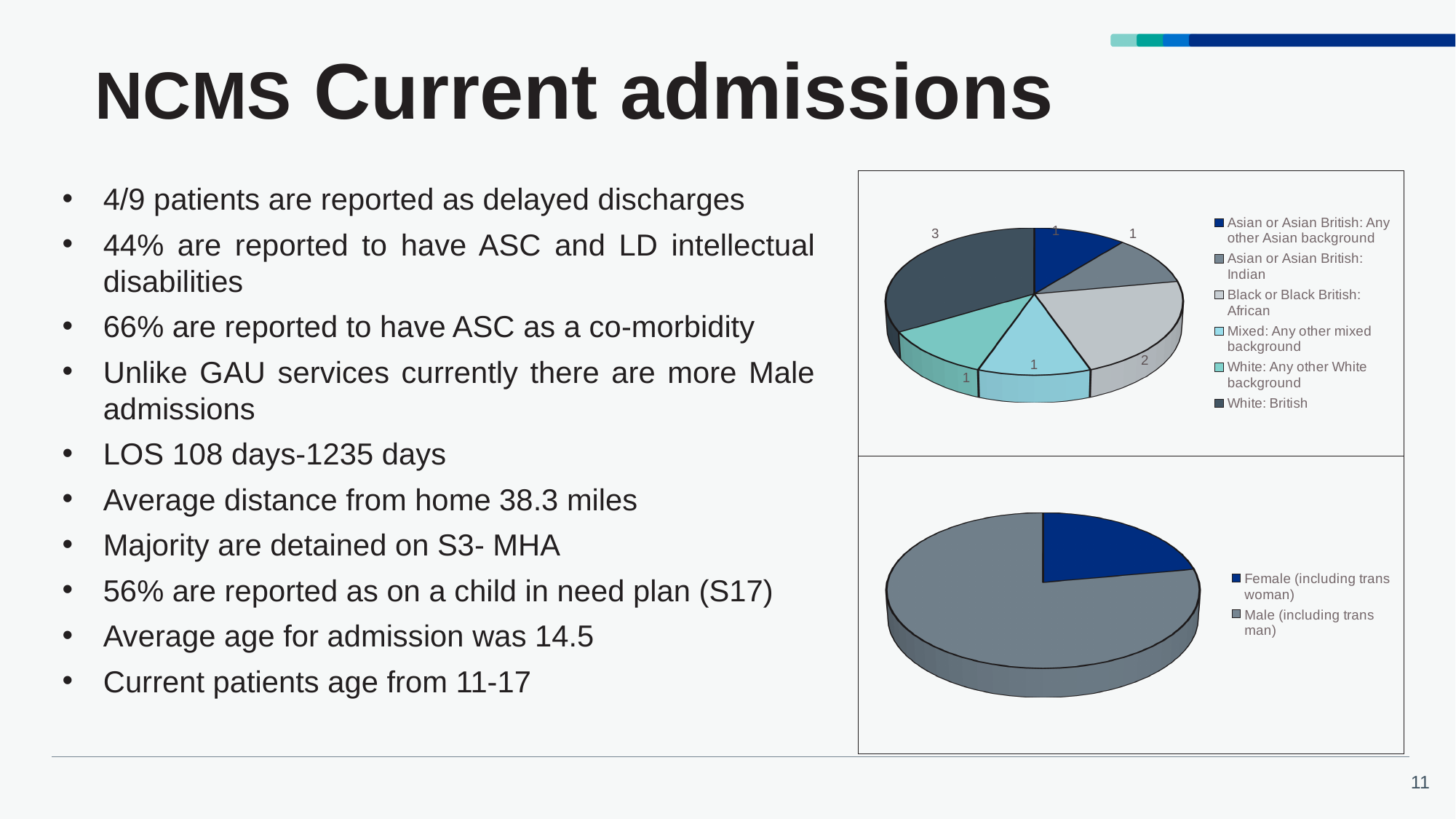
In the top pie chart, what is the value for Black or Black British: African? 2 In the top pie chart, which category has the largest slice? White: British In the top pie chart, how many categories does the legend list? 6 What kind of chart is the top chart on the slide? pie chart In the top pie chart, what is the total of all the slice values? 9 In the top pie chart, what is the difference between the values for White: British and Black or Black British: African? 1 In the top pie chart, which is larger: Black or Black British: African or Asian or Asian British: Indian? Black or Black British: African In the top pie chart, what is the value for White: British? 3 What kind of chart is the bottom chart on the slide? pie chart In the bottom pie chart, how many categories does the legend list? 2 In the top pie chart, what is the value for Mixed: Any other mixed background? 1 In the bottom pie chart, which category has the larger slice? Male (including trans man)